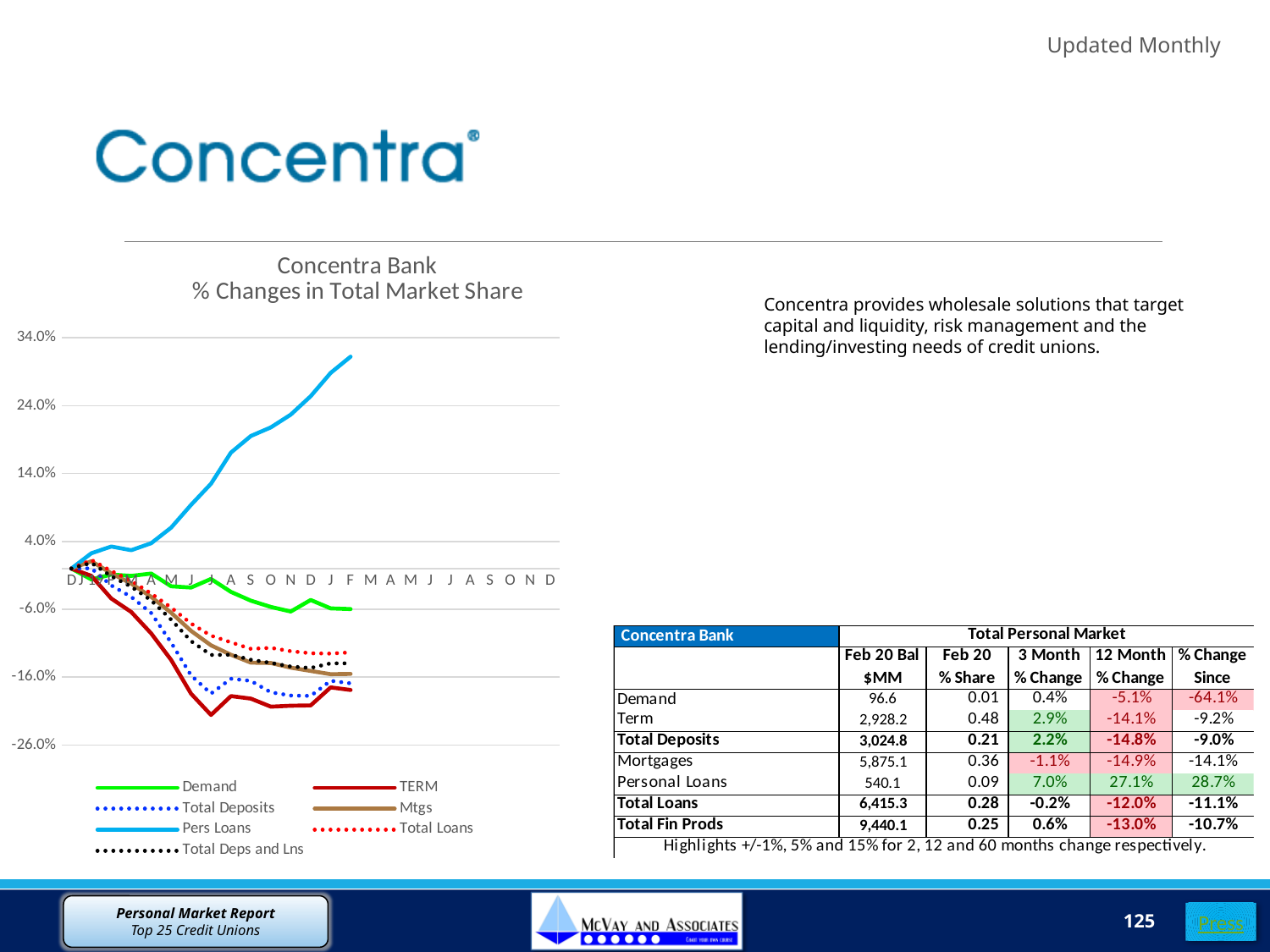
What kind of chart is shown on the slide? line chart Is the highest value of the Pers Loans series greater or less than 24.0%? greater Which series is plotted with a light blue solid line? Pers Loans Which series reaches the highest value on the chart? Pers Loans Which series reaches the lowest value on the chart? TERM What is the title of the chart? Concentra Bank % Changes in Total Market Share Is the lowest value of the TERM series greater or less than -16.0%? less Is the final value of the Demand series greater or less than 4.0%? less At the end of the plotted period, which is larger: the Demand series or the TERM series? Demand Does the Pers Loans series rise or fall over the plotted period? rise How many series does the chart legend list? 7 Does the TERM series rise or fall over the plotted period? fall